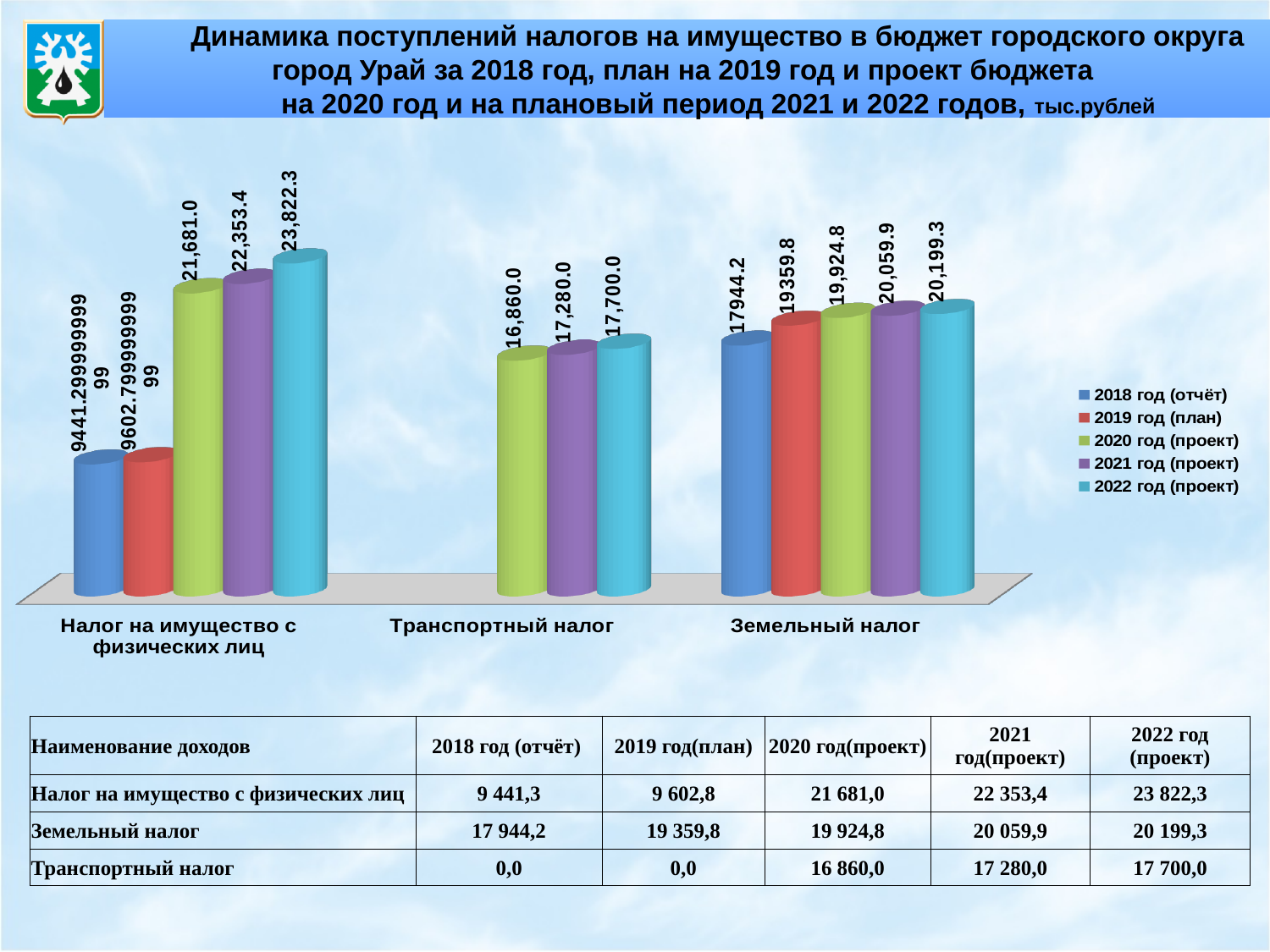
What kind of chart is shown on the slide? bar chart What is the difference between the 2022 год (проект) and 2020 год (проект) values for Транспортный налог? 840.0 For Земельный налог, which series has the lowest value? 2018 год (отчёт) What is the value for Налог на имущество с физических лиц in the 2022 год (проект) series? 23,822.3 In the 2020 год (проект) series, which is larger: Земельный налог or Транспортный налог? Земельный налог How many series does the legend list? 5 What is the difference between the 2022 год (проект) and 2021 год (проект) values for Налог на имущество с физических лиц? 1,468.9 How many categories are shown on the x axis of the chart? 3 Do the values for Налог на имущество с физических лиц rise or fall from the 2018 год (отчёт) series to the 2022 год (проект) series? rise Which category has the highest value in the 2022 год (проект) series? Налог на имущество с физических лиц What is the value for Транспортный налог in the 2020 год (проект) series? 16,860.0 What is the value for Земельный налог in the 2022 год (проект) series? 20,199.3